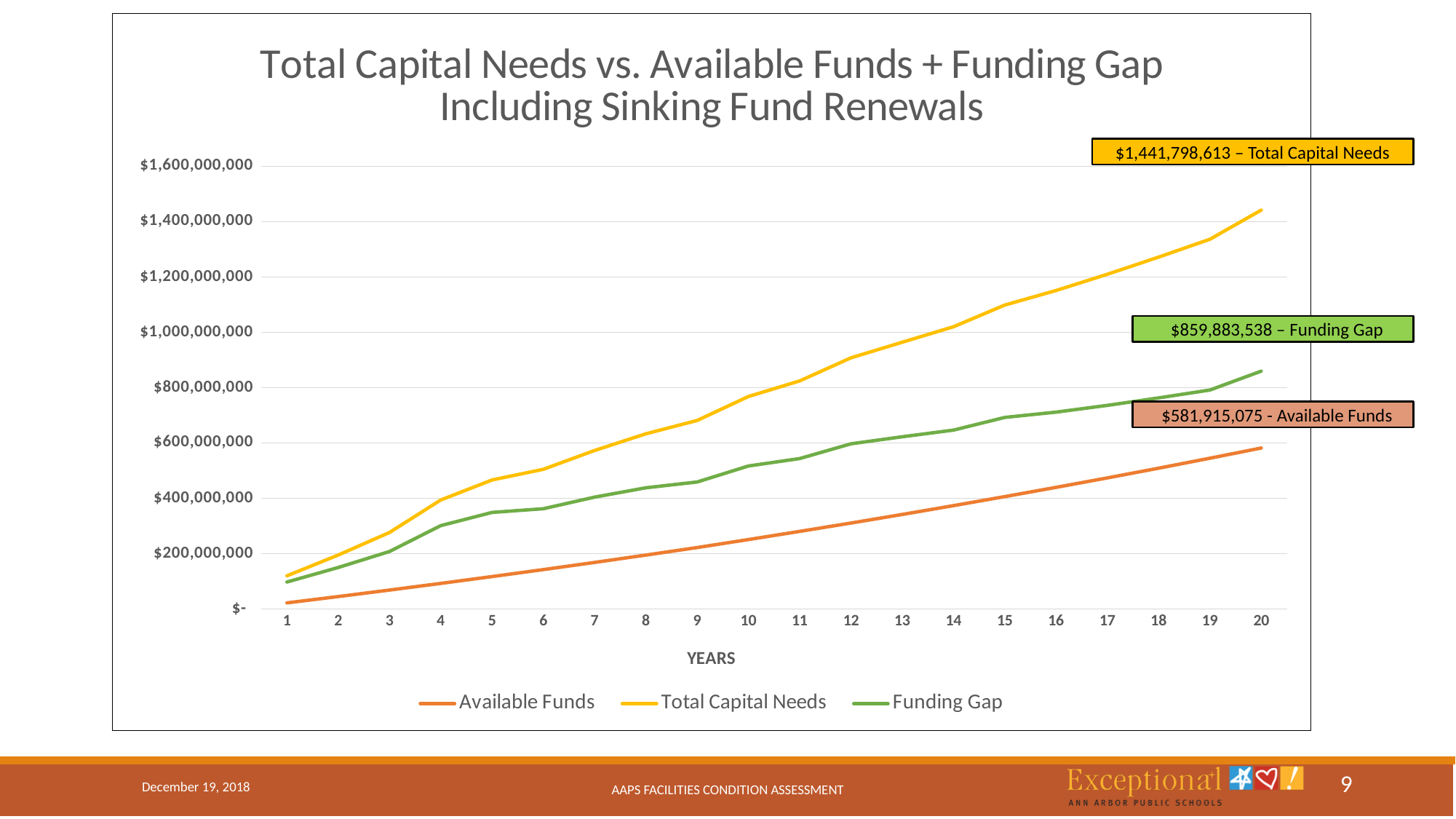
What kind of chart is shown on the slide? line chart Which series has the lowest value at year 20? Available Funds What is the difference between Total Capital Needs and Available Funds at year 20? $859,883,538 How many years are shown along the x axis? 20 What is the Total Capital Needs value at year 20, as shown in the callout? $1,441,798,613 At year 20, which is larger: Funding Gap or Available Funds? Funding Gap Do the Available Funds values rise or fall from year 1 to year 20? rise Is the Total Capital Needs value at year 10 greater or less than $600,000,000? greater Which series has the highest value at year 20? Total Capital Needs What is the Available Funds value at year 20, as shown in the callout? $581,915,075 What is the Funding Gap value at year 20, as shown in the callout? $859,883,538 How many series does the legend list? 3